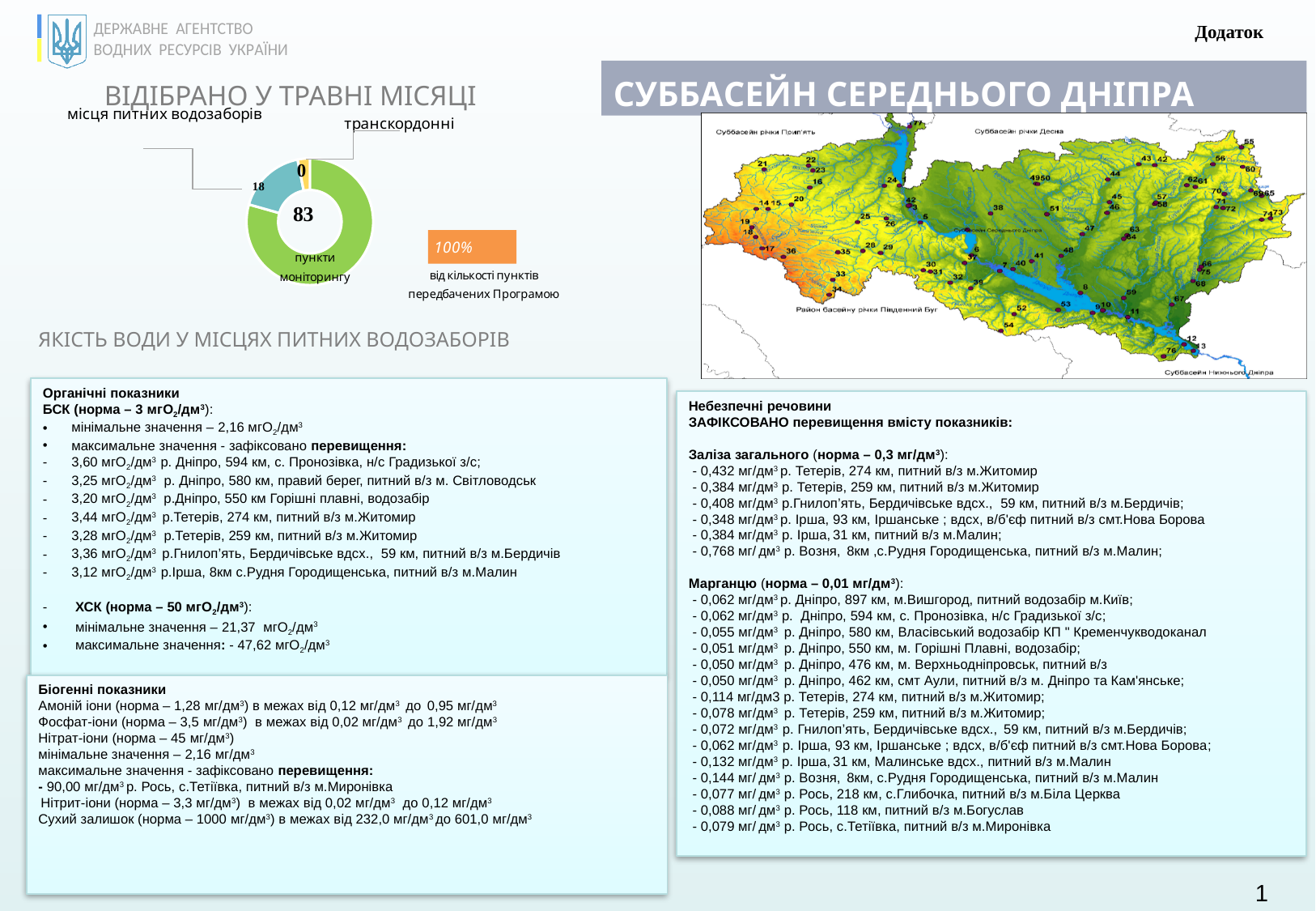
In the doughnut chart, which is larger: пункти моніторингу or місця питних водозаборів? пункти моніторингу What colour is the largest segment of the doughnut chart? green What is the difference between the values for пункти моніторингу and місця питних водозаборів in the doughnut chart? 65 In the doughnut chart, what value is shown for пункти моніторингу? 83 How many categories are shown in the doughnut chart? 3 In the doughnut chart, what value is shown for транскордонні? 0 What is the total of all values shown in the doughnut chart? 101 What is the heading above the doughnut chart? ВІДІБРАНО У ТРАВНІ МІСЯЦІ What kind of chart is used under the heading ВІДІБРАНО У ТРАВНІ МІСЯЦІ? doughnut (pie) chart Which category has the smallest value in the doughnut chart? транскордонні Which category has the largest value in the doughnut chart? пункти моніторингу In the doughnut chart, what value is shown for місця питних водозаборів? 18